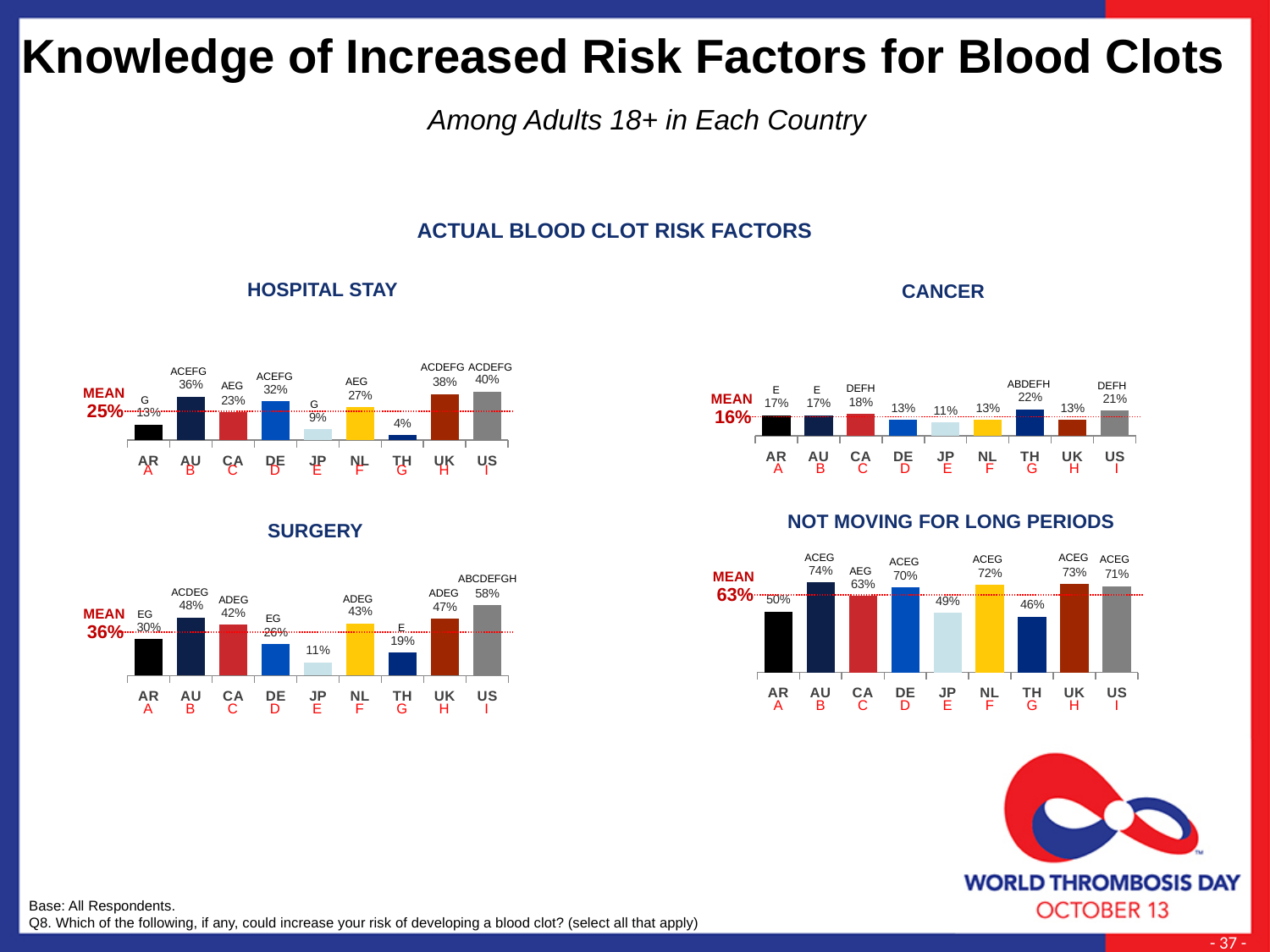
How many countries are shown in the Surgery chart? 9 In the Hospital Stay chart, what is the difference between the values for UK and AR? 25% In the Cancer chart, what is the value for JP? 11% In the Surgery chart, which is larger, the value for AU or the value for UK? AU In the Not Moving for Long Periods chart, which country has the lowest value? TH In the Not Moving for Long Periods chart, what is the value for DE? 70% What kind of chart is the Cancer chart? Bar chart In the Cancer chart, which country has the highest value? TH In the Hospital Stay chart, what is the value for US? 40% What is the mean value shown on the Not Moving for Long Periods chart? 63% In the Surgery chart, what is the difference between the values for US and JP? 47% In the Hospital Stay chart, which country has the lowest value? TH